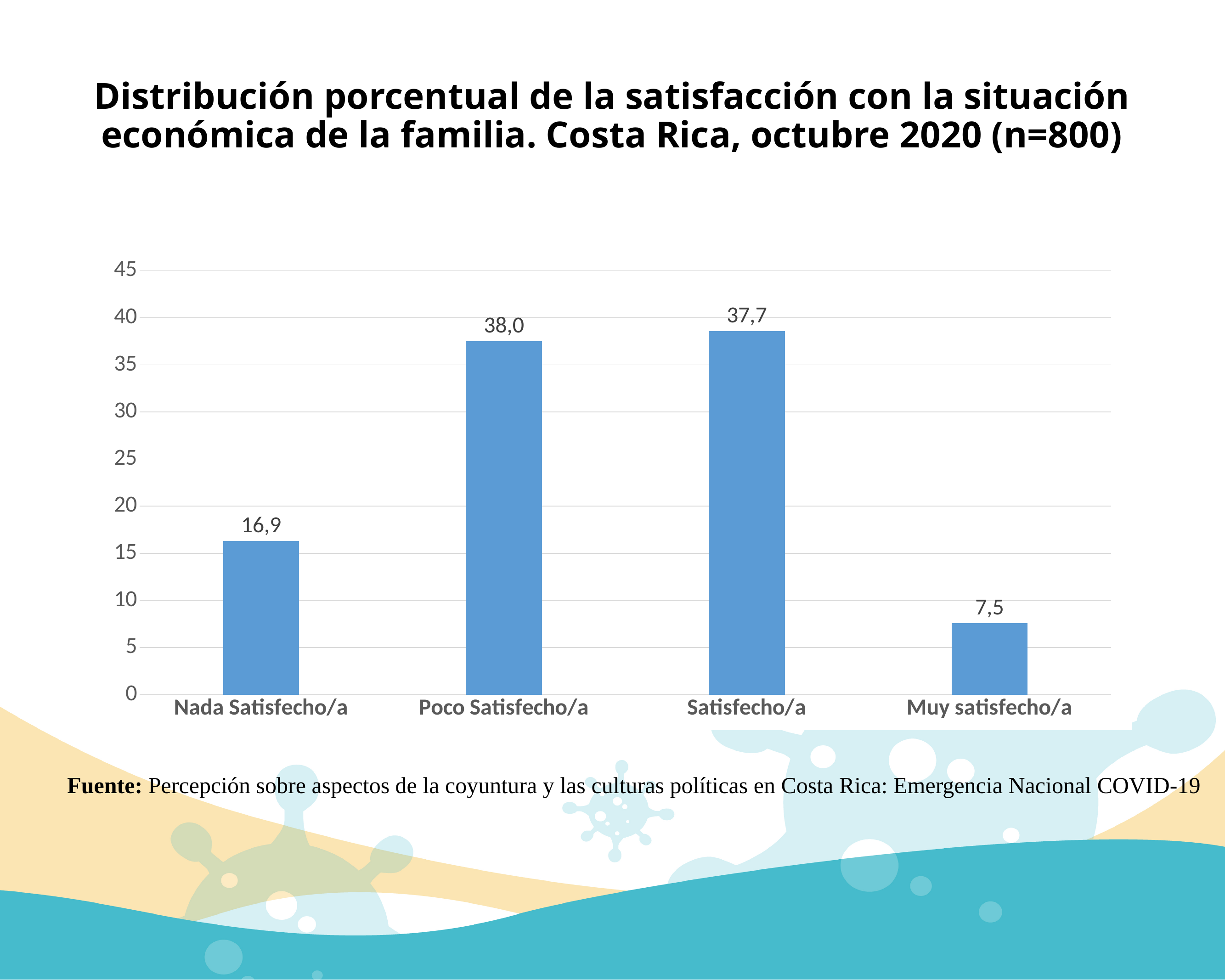
What is the value for Muy satisfecho/a? 7,5 What is the value for Nada Satisfecho/a? 16,9 What is the value for Poco Satisfecho/a? 38,0 Which category has the lowest value? Muy satisfecho/a How many categories are shown on the x axis? 4 What is the value for Satisfecho/a? 37,7 Is the value for Satisfecho/a greater or less than 35? greater What is the difference between the values for Poco Satisfecho/a and Nada Satisfecho/a? 21,1 What kind of chart is shown on the slide? bar chart Which is larger, the value for Nada Satisfecho/a or the value for Muy satisfecho/a? Nada Satisfecho/a What is the difference between the values for Nada Satisfecho/a and Muy satisfecho/a? 9,4